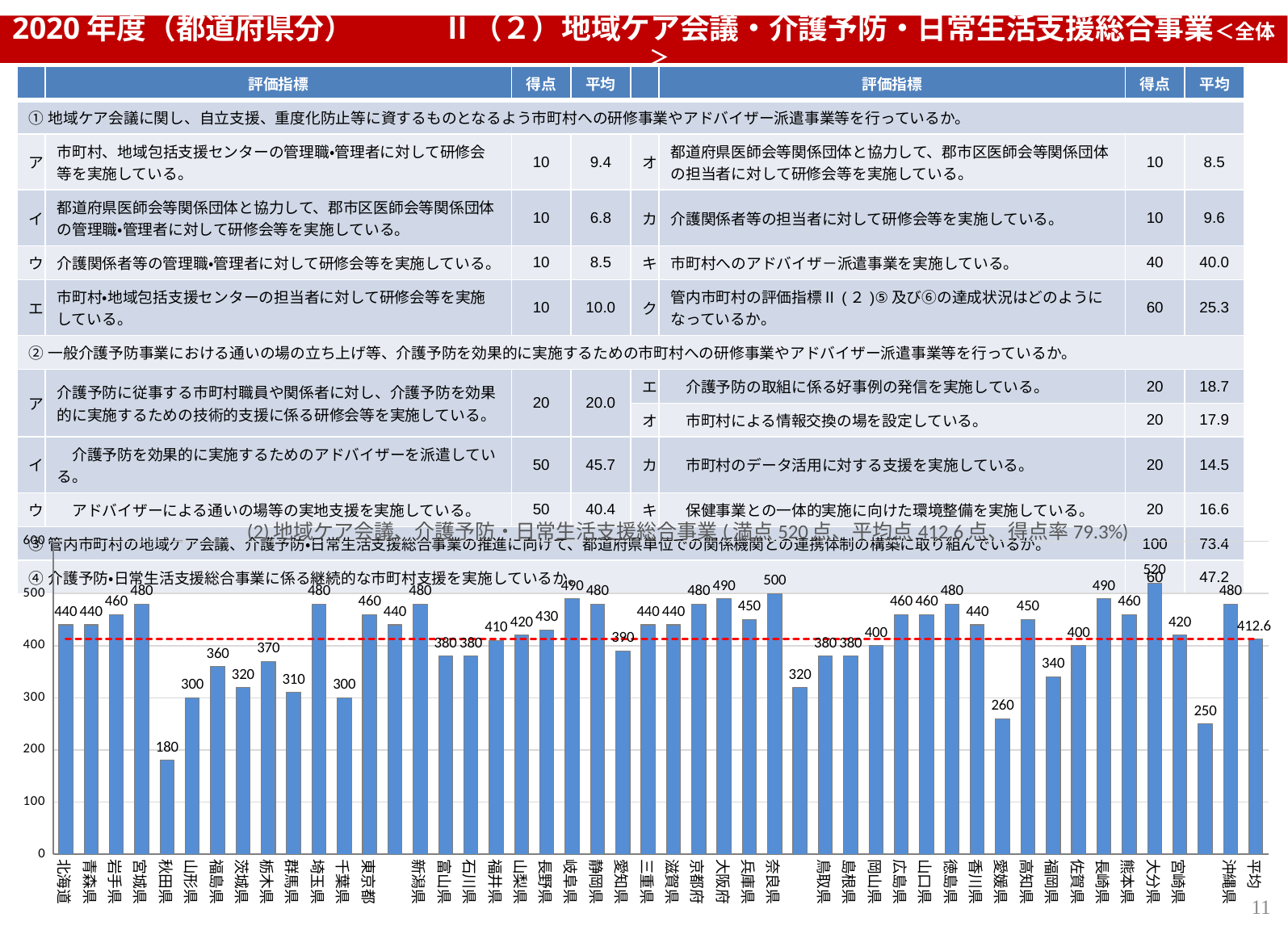
What is the value for 奈良県 in the bar chart? 500 What is the value for 愛媛県 in the bar chart? 260 What is the value for 秋田県 in the bar chart? 180 Which category has the highest value in the bar chart? 大分県 According to the chart title, what is the 得点率? 79.3% Which category has the lowest value in the bar chart? 秋田県 What is the value shown for 平均 at the right end of the bar chart? 412.6 What is the difference between the values for 岐阜県 and 愛知県? 100 Which is larger, the value for 福岡県 or the value for 佐賀県? 佐賀県 Is the value for 山形県 greater or less than 400? less What kind of chart is shown on the slide? combination bar and line chart (bars with a dashed average line) What is the difference between the values for 大分県 and 秋田県? 340